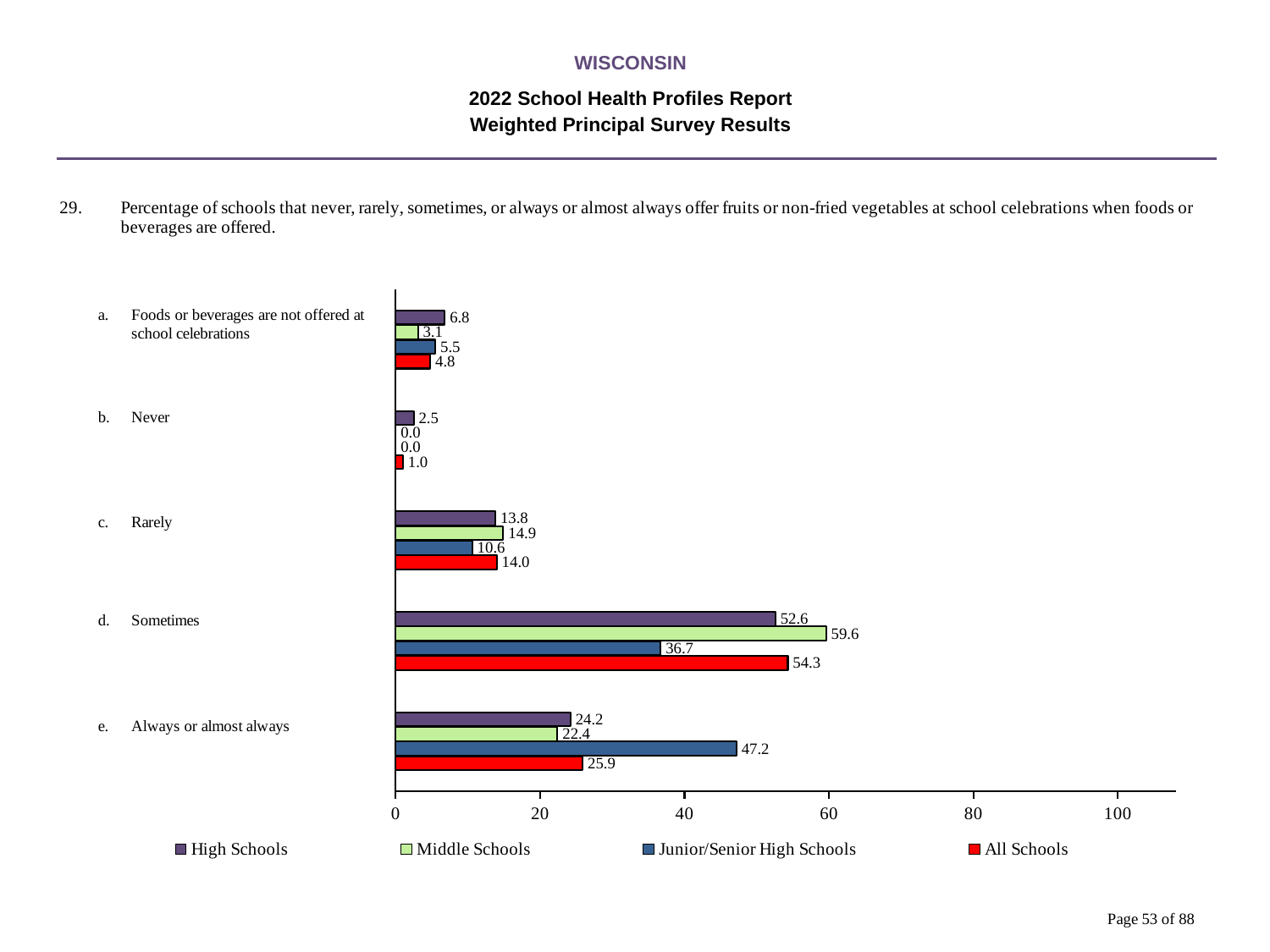
What is the value for All Schools in the 'Rarely' category? 14.0 What is the value for Middle Schools in the 'Sometimes' category? 59.6 Which category has the lowest value for High Schools? Never How many categories are shown on the chart? 5 Which category has the highest value for All Schools? Sometimes In the 'Always or almost always' category, which is larger: the value for High Schools or for Junior/Senior High Schools? Junior/Senior High Schools What kind of chart is shown on the slide? bar chart What is the value for High Schools in the 'Never' category? 2.5 How many series does the legend list? 4 What is the difference between the Middle Schools and Junior/Senior High Schools values in the 'Sometimes' category? 22.9 Is the value for All Schools in the 'Sometimes' category greater or less than 40? greater What is the value for Junior/Senior High Schools in the 'Always or almost always' category? 47.2